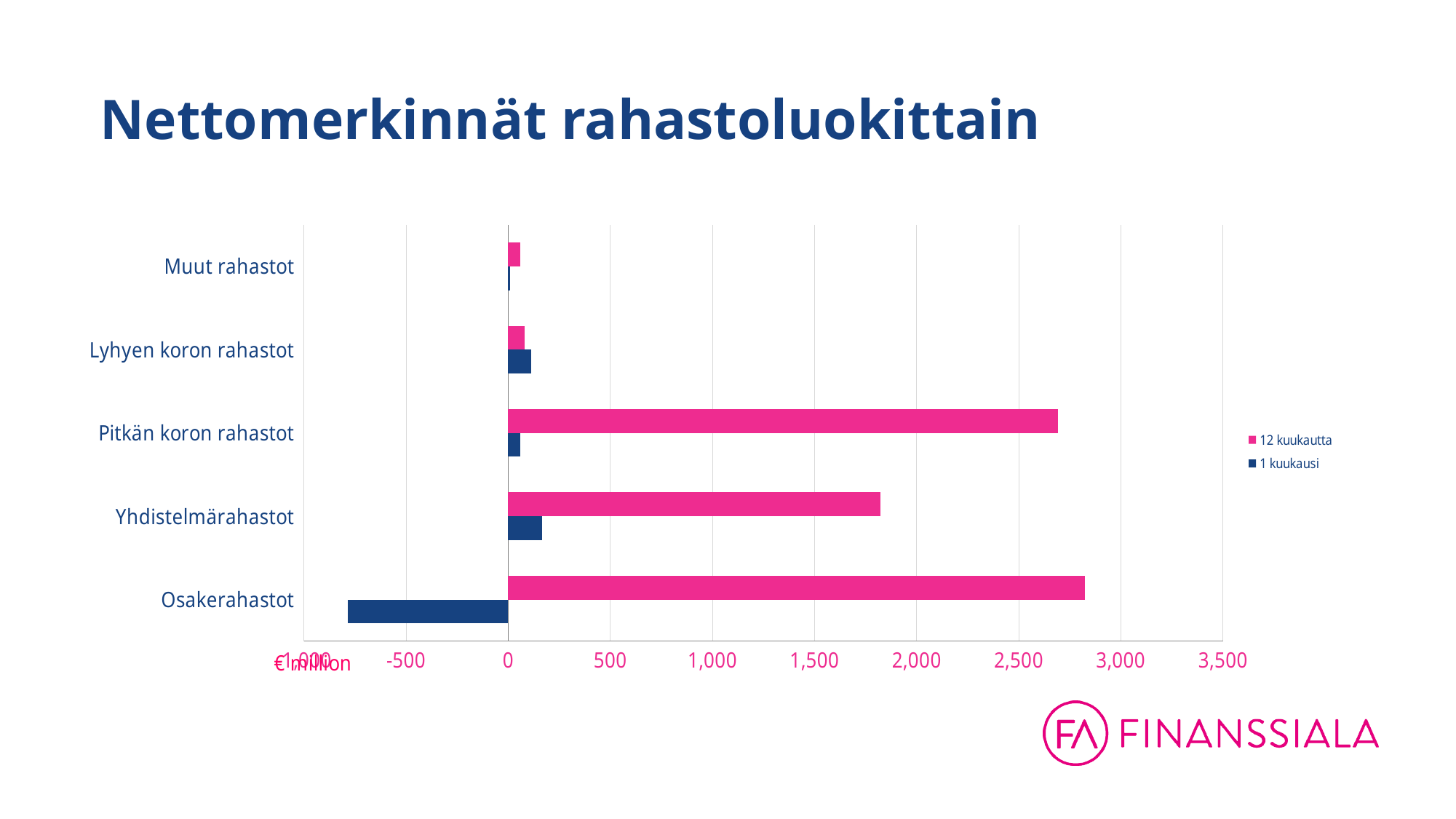
Is the 12 kuukautta value for Osakerahastot greater or less than 2,500? greater For the 1 kuukausi series, which is larger: Yhdistelmärahastot or Osakerahastot? Yhdistelmärahastot How many series does the legend list? 2 Is the 12 kuukautta value for Yhdistelmärahastot greater or less than 2,000? less Which colour represents the 1 kuukausi series in the legend? Dark blue What kind of chart is shown on the slide? Bar chart Is the 1 kuukausi value for Osakerahastot greater or less than -500? less Which category has the lowest value for the 1 kuukausi series? Osakerahastot How many fund categories are shown on the chart? 5 For the 12 kuukautta series, which is larger: Pitkän koron rahastot or Yhdistelmärahastot? Pitkän koron rahastot Which category has the highest value for the 12 kuukautta series? Osakerahastot